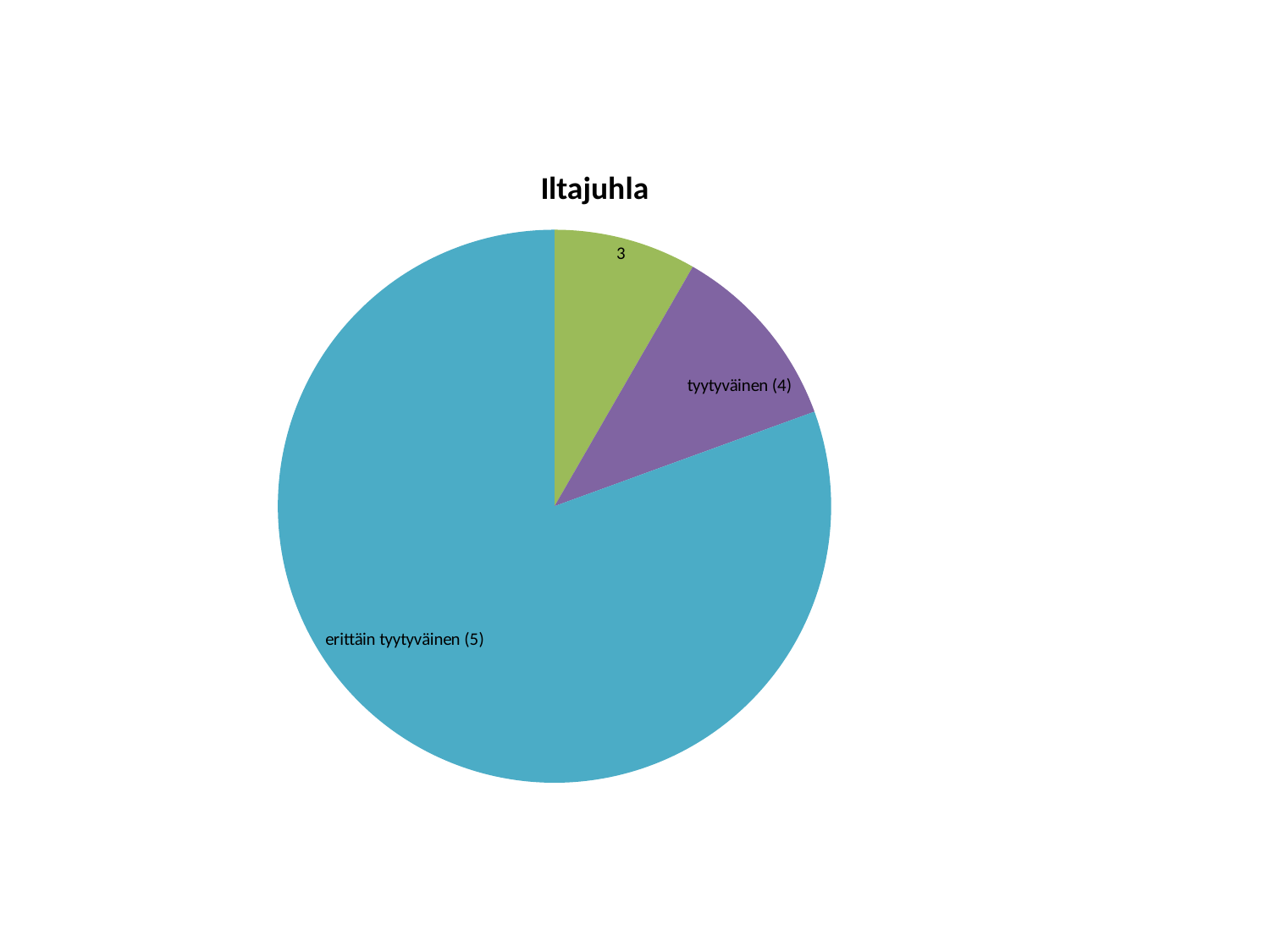
What is the title of the chart? Iltajuhla Which slice is larger: erittäin tyytyväinen (5) or tyytyväinen (4)? erittäin tyytyväinen (5) What colour is the slice labelled tyytyväinen (4)? purple Which slice is the smallest in the pie chart? 3 What kind of chart is shown on the slide? pie chart How many slices does the pie chart have? 3 Which slice is the largest in the pie chart? erittäin tyytyväinen (5) Which slice is larger: tyytyväinen (4) or 3? tyytyväinen (4) Does the slice erittäin tyytyväinen (5) take up more or less than half of the pie? more